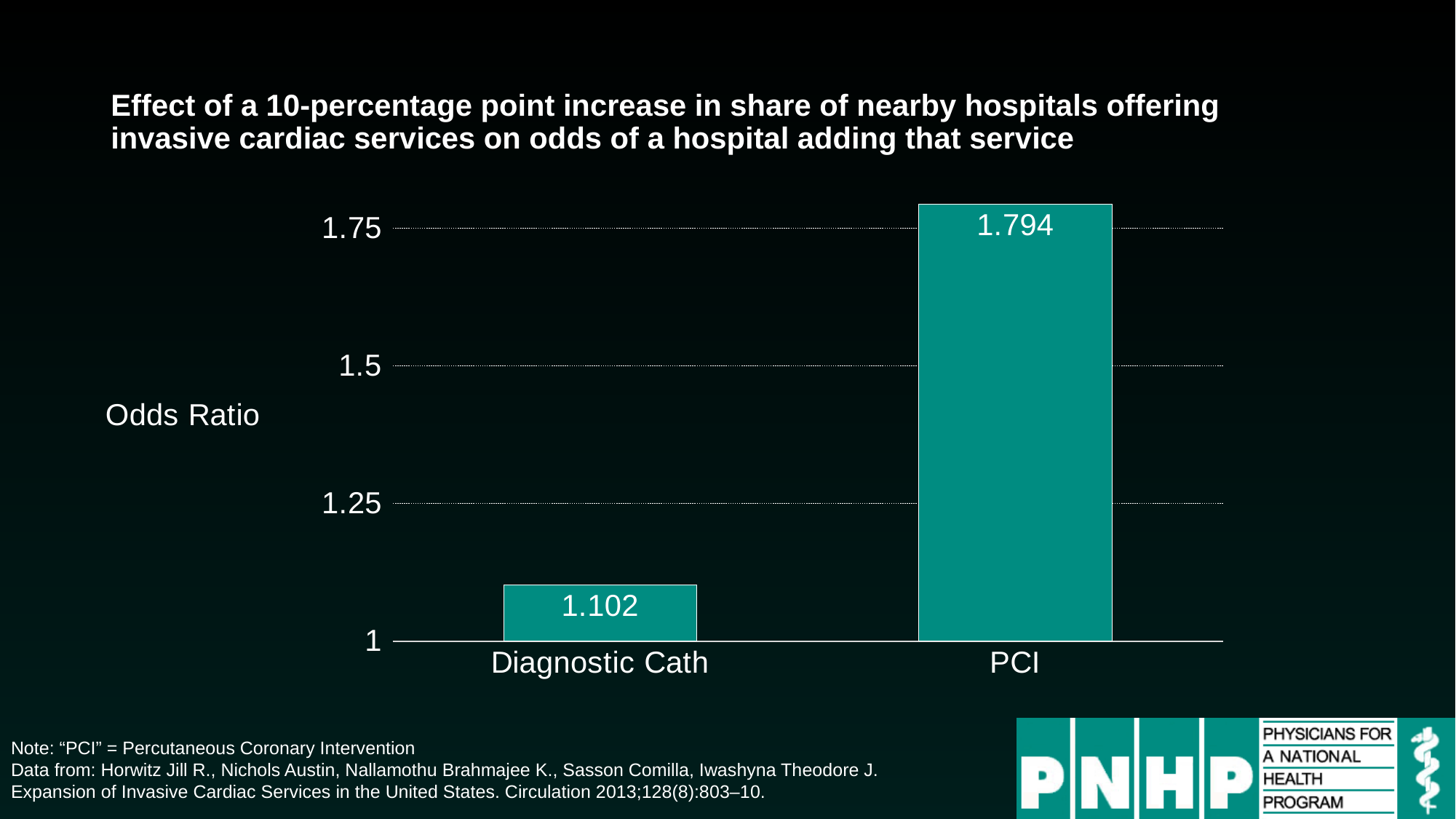
What is the odds ratio for Diagnostic Cath? 1.102 Is the odds ratio for Diagnostic Cath greater or less than 1.25? less What is the odds ratio for PCI? 1.794 How many categories are shown on the chart? 2 Which category has the lower odds ratio? Diagnostic Cath According to the note on the slide, what does "PCI" stand for? Percutaneous Coronary Intervention What is the difference between the odds ratio for PCI and the odds ratio for Diagnostic Cath? 0.692 Which category has the higher odds ratio? PCI What kind of chart is shown on the slide? Bar chart Is the odds ratio for PCI greater or less than 1.75? greater What is the label on the vertical axis of the chart? Odds Ratio